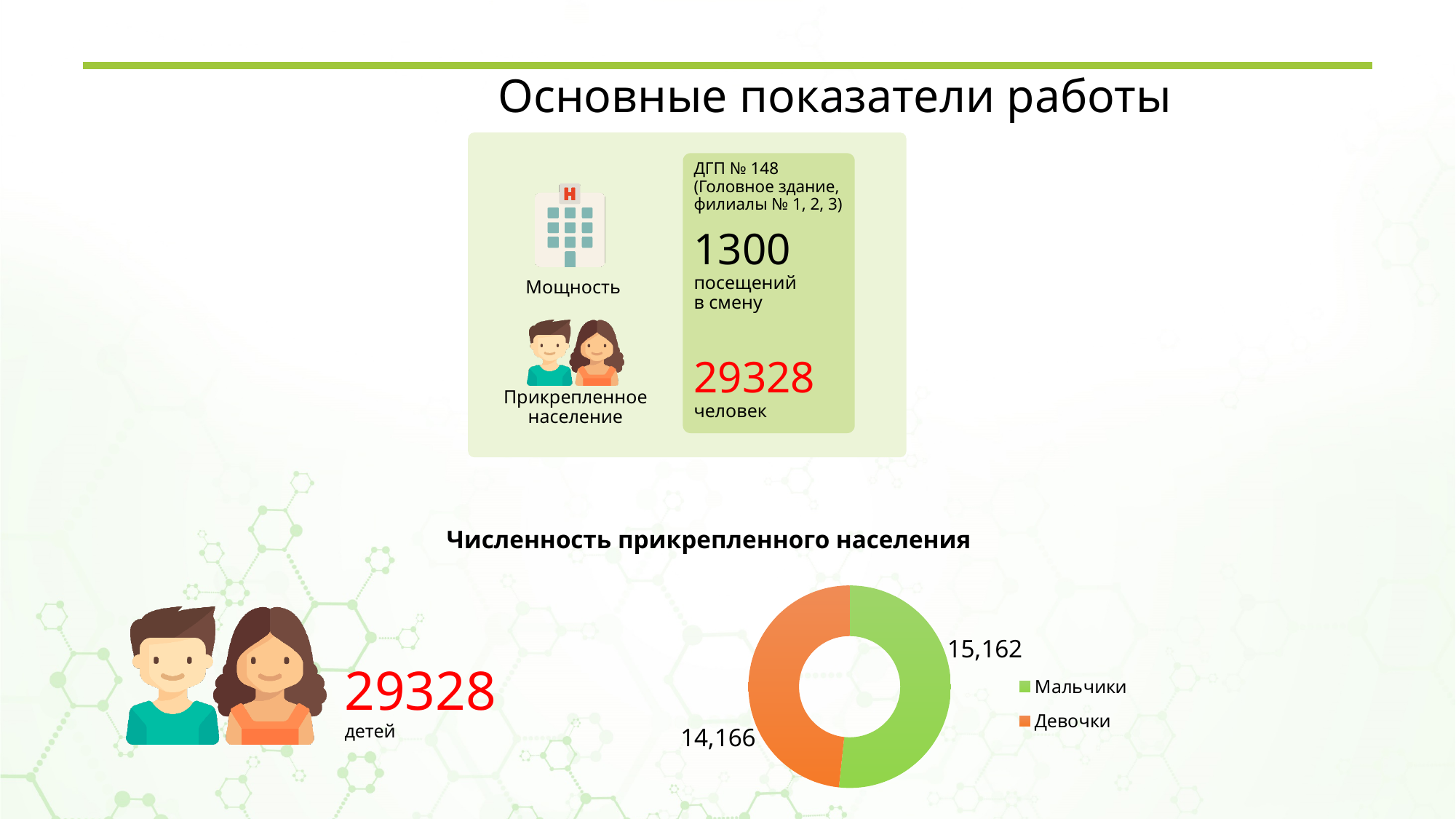
What colour is the Девочки slice in the chart "Численность прикрепленного населения"? Orange What kind of chart is "Численность прикрепленного населения"? Doughnut (pie) chart In the chart "Численность прикрепленного населения", which is larger: Мальчики or Девочки? Мальчики How many categories are shown in the chart "Численность прикрепленного населения"? 2 Which category has the largest slice in the chart "Численность прикрепленного населения"? Мальчики How many entries does the legend of the chart "Численность прикрепленного населения" list? 2 What is the value for Мальчики in the chart "Численность прикрепленного населения"? 15,162 In the chart "Численность прикрепленного населения", what is the difference between the values for Мальчики and Девочки? 996 What is the value for Девочки in the chart "Численность прикрепленного населения"? 14,166 What is the total of the two slices in the chart "Численность прикрепленного населения"? 29,328 Which category has the smallest slice in the chart "Численность прикрепленного населения"? Девочки